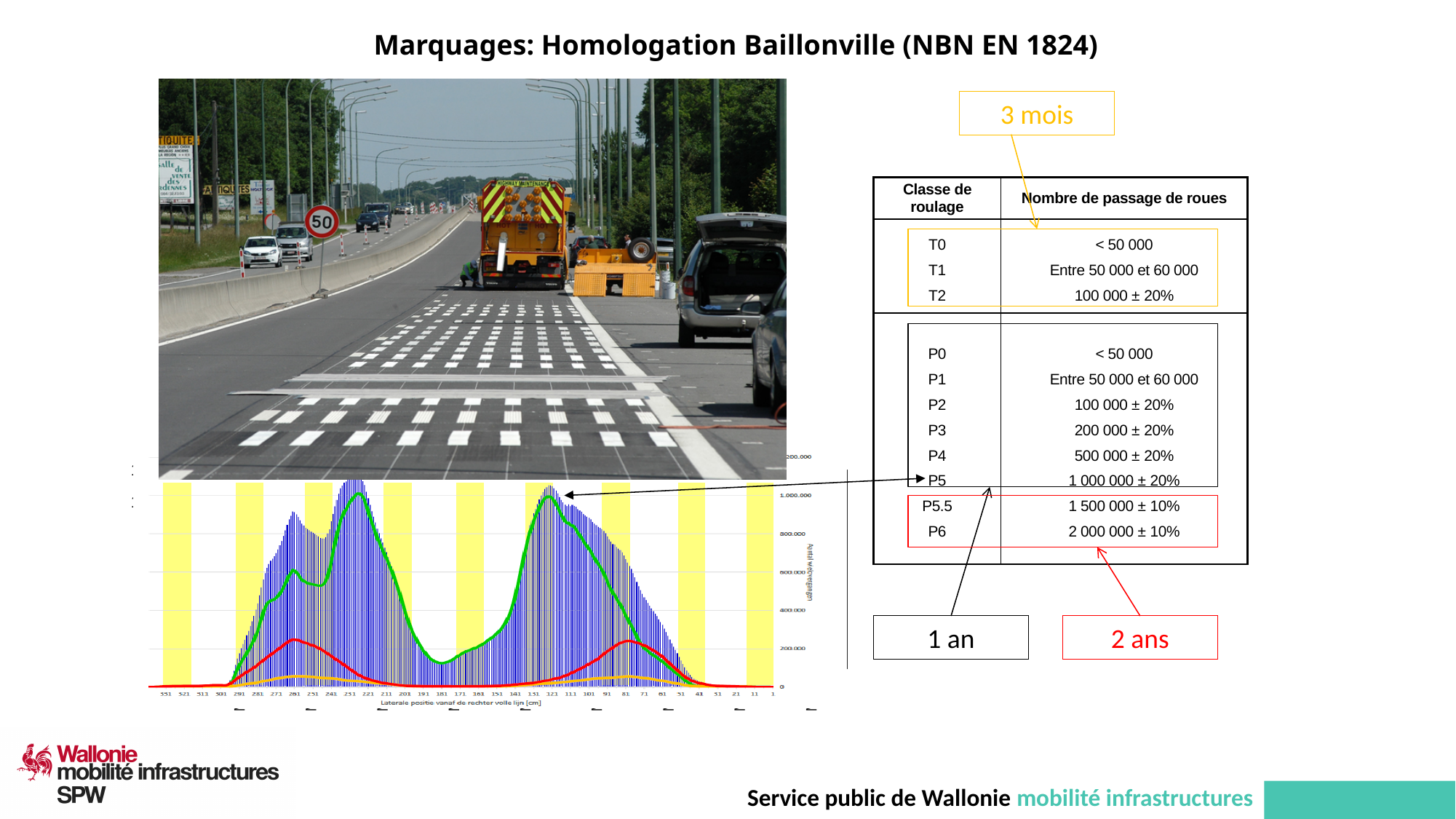
What kind of chart is shown at the bottom left of the slide? bar chart with line overlays In the bottom-left chart, is the highest point of the orange line greater or less than 200.000? less In the bottom-left chart, what is the title of the horizontal axis? Laterale positie vanaf de rechter volle lijn [cm] In the bottom-left chart, is the highest point of the red line greater or less than 400.000? less In the bottom-left chart, what is the lowest tick value on the vertical axis? 0 In the bottom-left chart, is the peak of the green line around position 241 greater or less than 800.000? greater In the bottom-left chart, what is the highest tick value shown on the right-hand vertical axis? 1.200.000 In the bottom-left chart, which line reaches higher values overall, the green line or the red line? green line